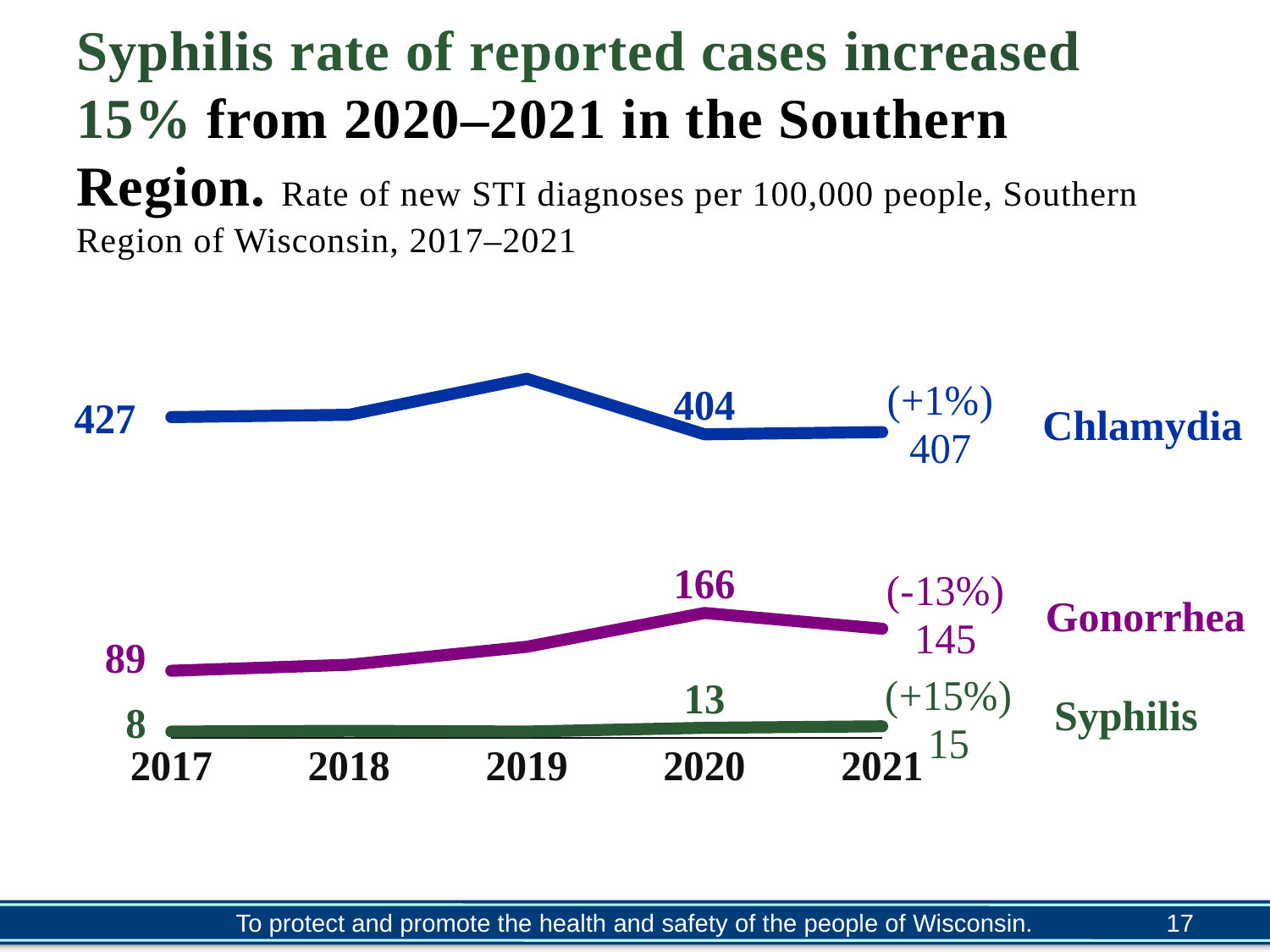
What was the chlamydia rate in 2017? 427 What was the syphilis rate in 2021? 15 Which was larger, the chlamydia rate in 2017 or in 2021? 2017 What was the gonorrhea rate in 2020? 166 What was the chlamydia rate in 2021? 407 Which STI had the highest rate in 2021? Chlamydia Did the syphilis rate rise or fall from 2017 to 2021? Rise Which STI had the lowest rate in 2017? Syphilis How many series are plotted on the chart? 3 By how much did the gonorrhea rate change from 2020 to 2021? Decreased by 21 What kind of chart is shown? Line chart How many years are shown on the x axis? 5